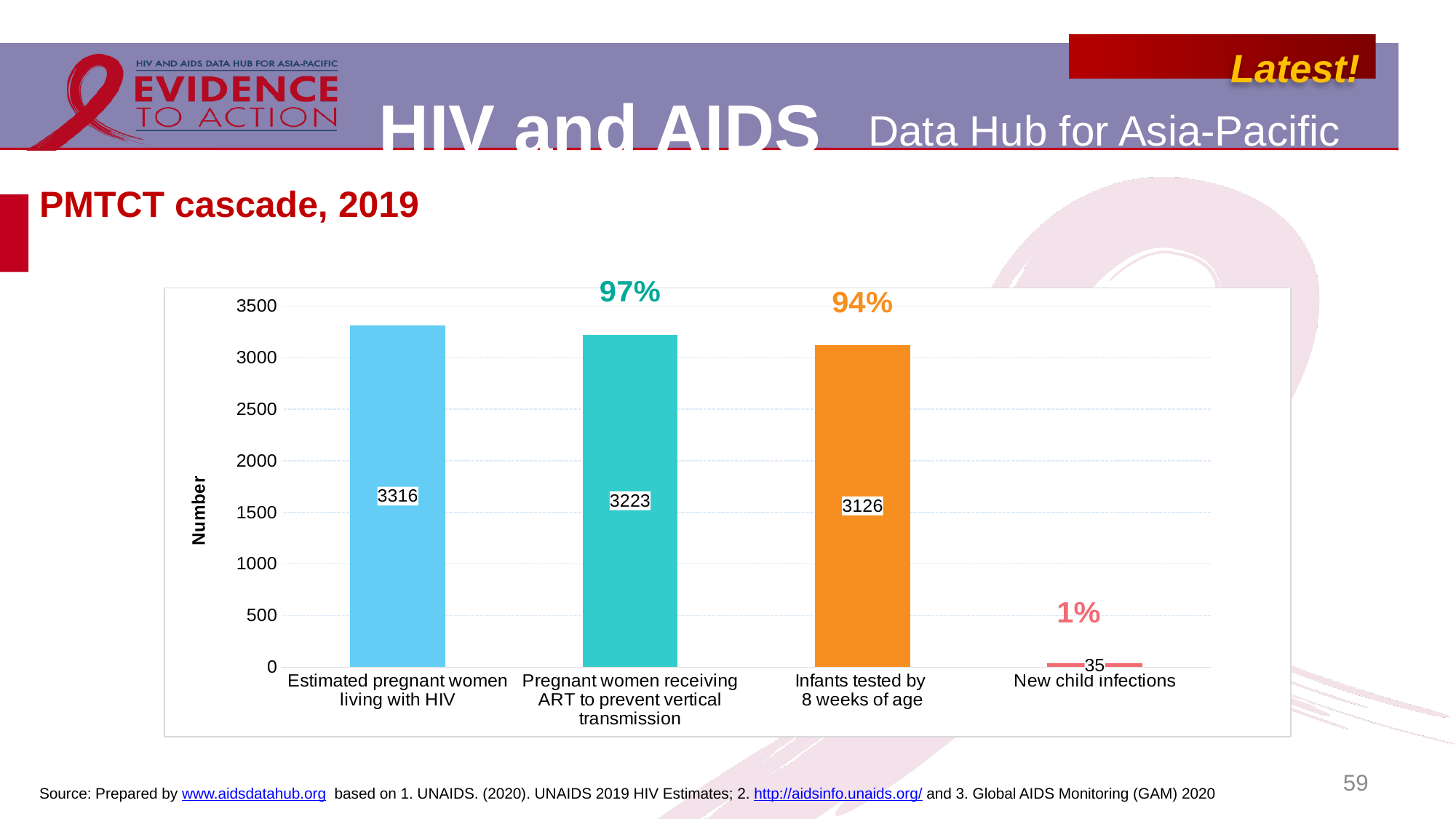
Which is larger: Infants tested by 8 weeks of age or New child infections? Infants tested by 8 weeks of age What is the difference between Pregnant women receiving ART to prevent vertical transmission and Infants tested by 8 weeks of age? 97 Which category has the highest value? Estimated pregnant women living with HIV What percentage label is shown above the Infants tested by 8 weeks of age bar? 94% What is the value for Estimated pregnant women living with HIV? 3316 What is the value for Infants tested by 8 weeks of age? 3126 Which category has the lowest value? New child infections What is the value for New child infections? 35 What kind of chart is shown on the slide? Bar chart What is the value for Pregnant women receiving ART to prevent vertical transmission? 3223 How many categories are shown on the x axis? 4 What is the difference between Estimated pregnant women living with HIV and Pregnant women receiving ART to prevent vertical transmission? 93